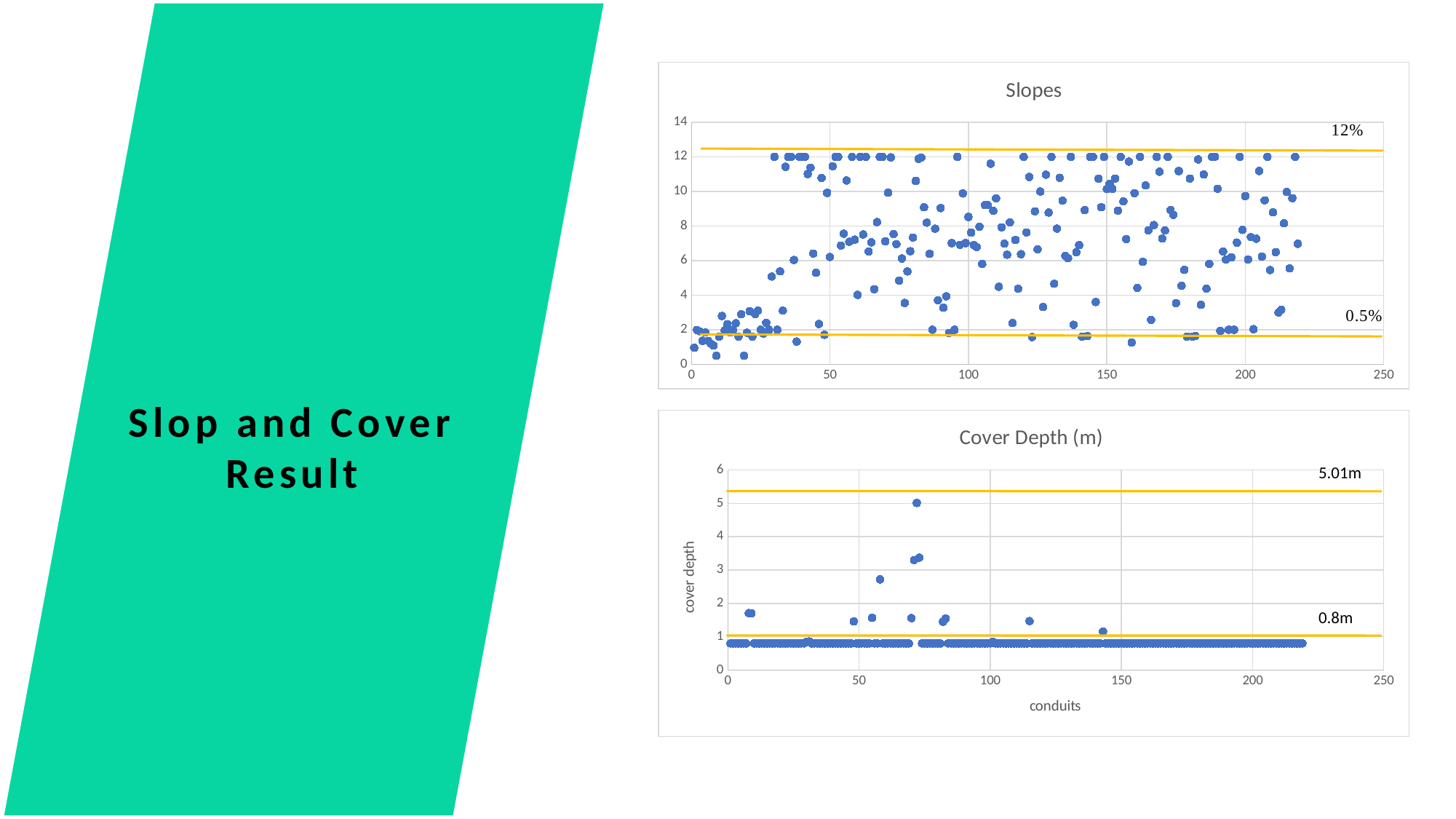
In the "Cover Depth (m)" chart, what label is printed next to the lower yellow reference line? 0.8m What kind of chart is the "Cover Depth (m)" chart? scatter chart In the "Slopes" chart, what label is printed next to the lower yellow reference line? 0.5% In the "Cover Depth (m)" chart, is the highest plotted point greater or less than 4? greater In the "Cover Depth (m)" chart, what is the title of the vertical axis? cover depth In the "Cover Depth (m)" chart, what label is printed next to the upper yellow reference line? 5.01m How many charts are shown on the slide? 2 In the "Slopes" chart, what label is printed next to the upper yellow reference line? 12% In the "Cover Depth (m)" chart, is the value of the point near conduit 58 greater or less than 2? greater What kind of chart is the "Slopes" chart? scatter chart